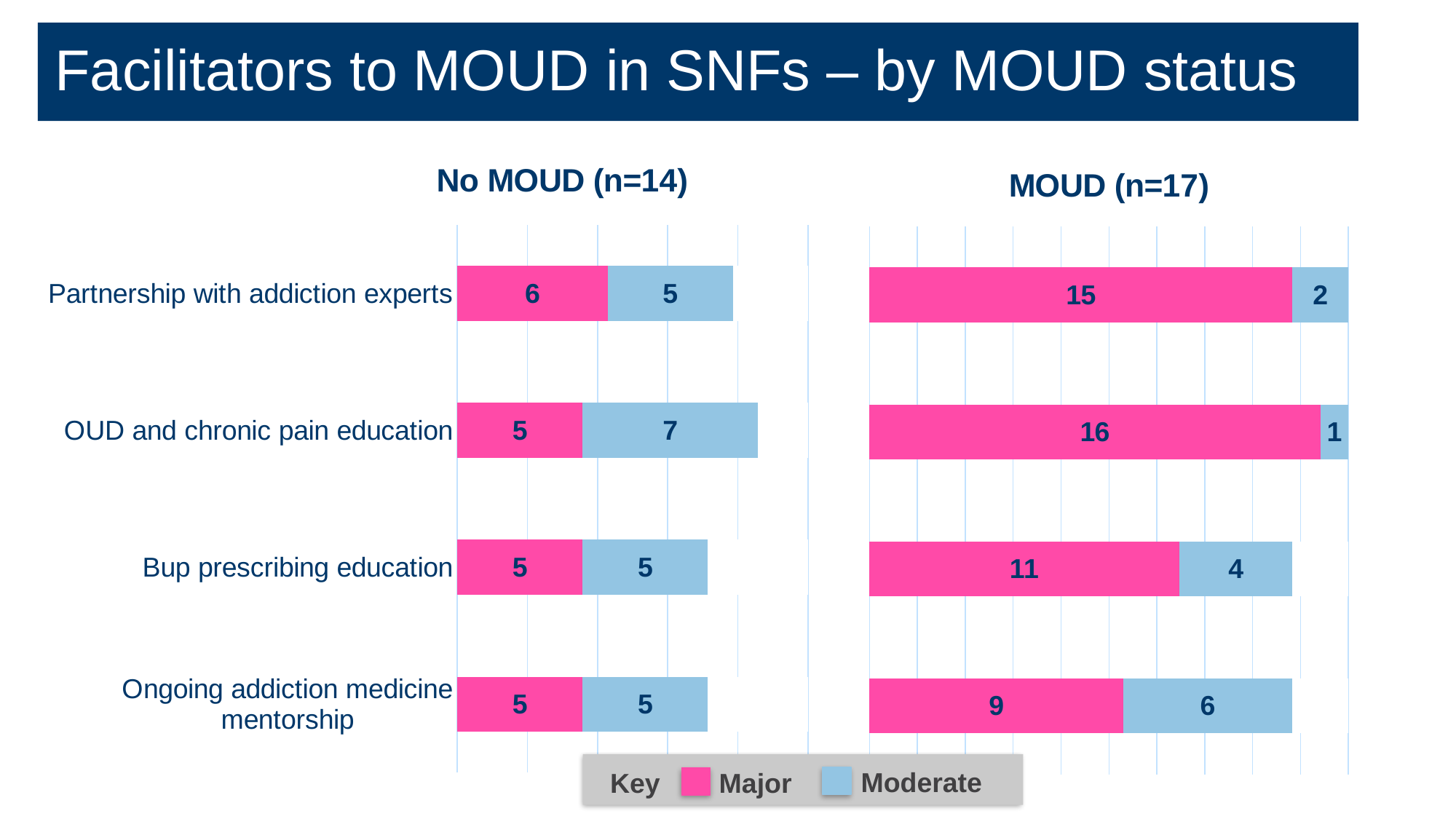
In the MOUD (n=17) chart, what is the difference between the Major values for Partnership with addiction experts and Ongoing addiction medicine mentorship? 6 How many categories are shown in the No MOUD (n=14) chart? 4 In the MOUD (n=17) chart, which category has the lowest Moderate value? OUD and chronic pain education In the No MOUD (n=14) chart, what is the Major value for Partnership with addiction experts? 6 In the MOUD (n=17) chart, what is the total of the stacked bar for Bup prescribing education? 15 In the MOUD (n=17) chart, which category has the highest Major value? OUD and chronic pain education In the No MOUD (n=14) chart, what is the Moderate value for OUD and chronic pain education? 7 In the No MOUD (n=14) chart, what is the total of the stacked bar for OUD and chronic pain education? 12 How many series does the key list? 2 Which is larger: the Major value for Bup prescribing education in the MOUD (n=17) chart or in the No MOUD (n=14) chart? MOUD (n=17) In the MOUD (n=17) chart, what is the Major value for OUD and chronic pain education? 16 In the MOUD (n=17) chart, what is the Moderate value for Bup prescribing education? 4